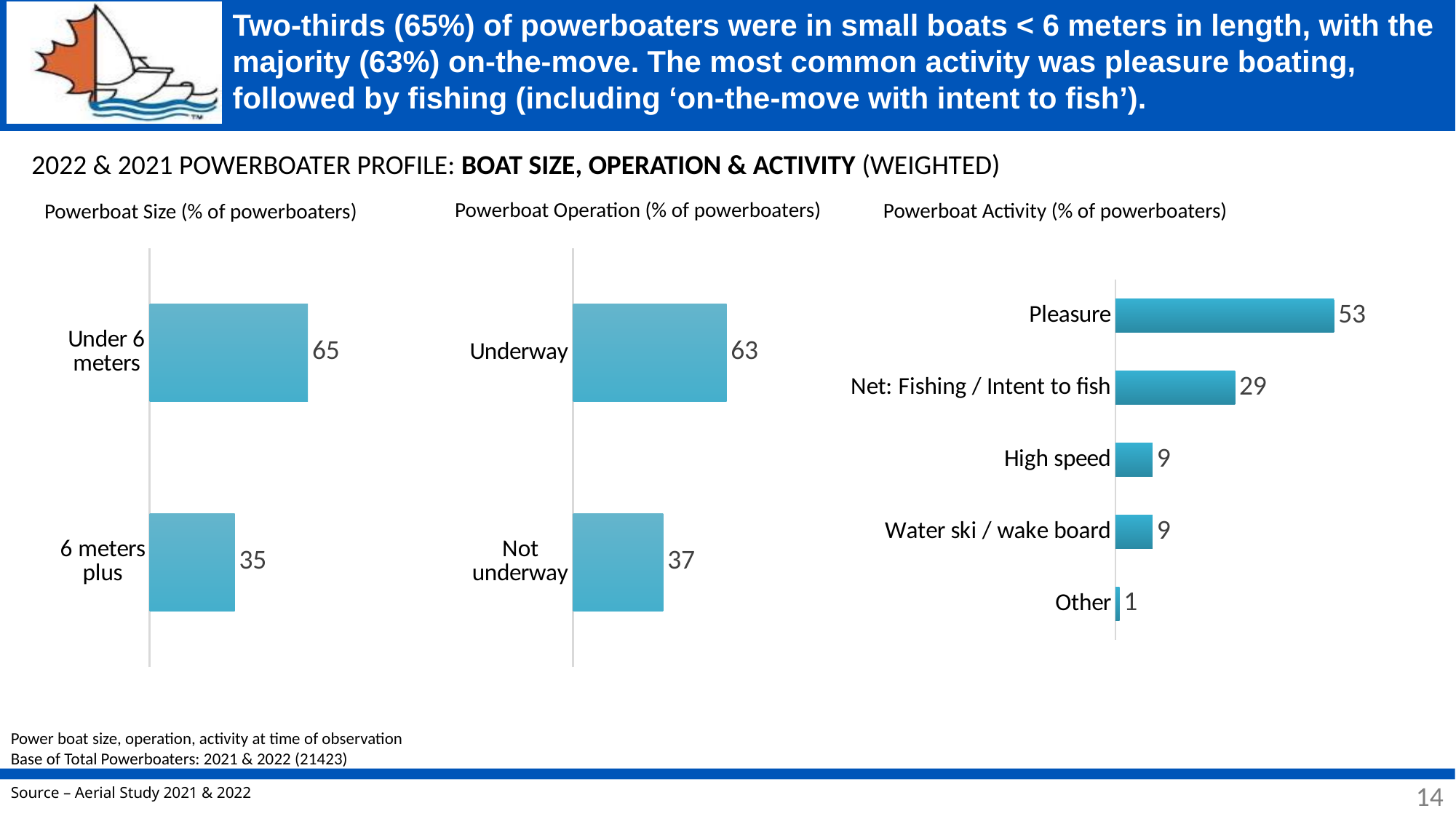
What kind of chart is the Powerboat Operation chart? Bar chart In the Powerboat Size chart, what is the value for Under 6 meters? 65 How many charts are shown on the slide? 3 In the Powerboat Activity chart, which category has the highest value? Pleasure In the Powerboat Operation chart, what is the difference between Underway and Not underway? 26 In the Powerboat Size chart, what is the value for 6 meters plus? 35 In the Powerboat Activity chart, what is the value for Net: Fishing / Intent to fish? 29 In the Powerboat Operation chart, what is the value for Not underway? 37 In the Powerboat Activity chart, which category has the lowest value? Other In the Powerboat Activity chart, what is the difference between Pleasure and Net: Fishing / Intent to fish? 24 In the Powerboat Activity chart, how many categories are shown? 5 In the Powerboat Size chart, which is larger: Under 6 meters or 6 meters plus? Under 6 meters